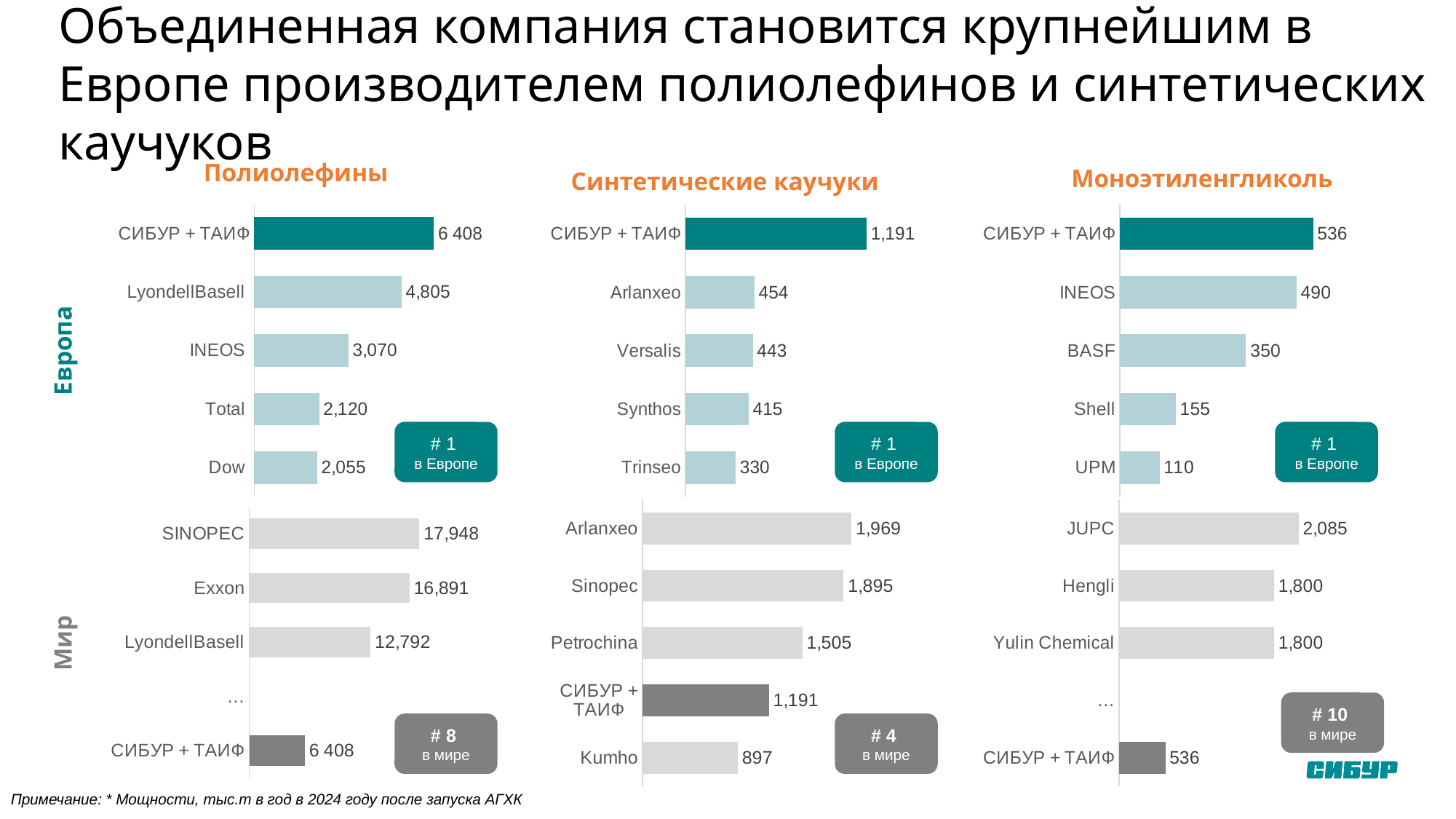
In the Синтетические каучуки chart (Европа section), what is the difference between СИБУР + ТАИФ and Arlanxeo? 737 In the Синтетические каучуки chart (Европа section), what is the value for Versalis? 443 How many companies are listed in the Европа section of the Синтетические каучуки chart? 5 What type of chart is used on this slide? Bar chart In the Полиолефины chart (Мир section), what is the difference between SINOPEC and Exxon? 1,057 In the Полиолефины chart (Европа section), what is the value for LyondellBasell? 4,805 In the Моноэтиленгликоль chart (Мир section), what is the value for JUPC? 2,085 In the Моноэтиленгликоль chart (Европа section), which is larger, BASF or Shell? BASF In the Моноэтиленгликоль chart (Европа section), which company has the lowest value? UPM In the Синтетические каучуки chart (Мир section), which is larger, Petrochina or Kumho? Petrochina What rank in the world does the СИБУР + ТАИФ label show for Моноэтиленгликоль? # 10 In the Полиолефины chart (Мир section), which company has the highest value? SINOPEC